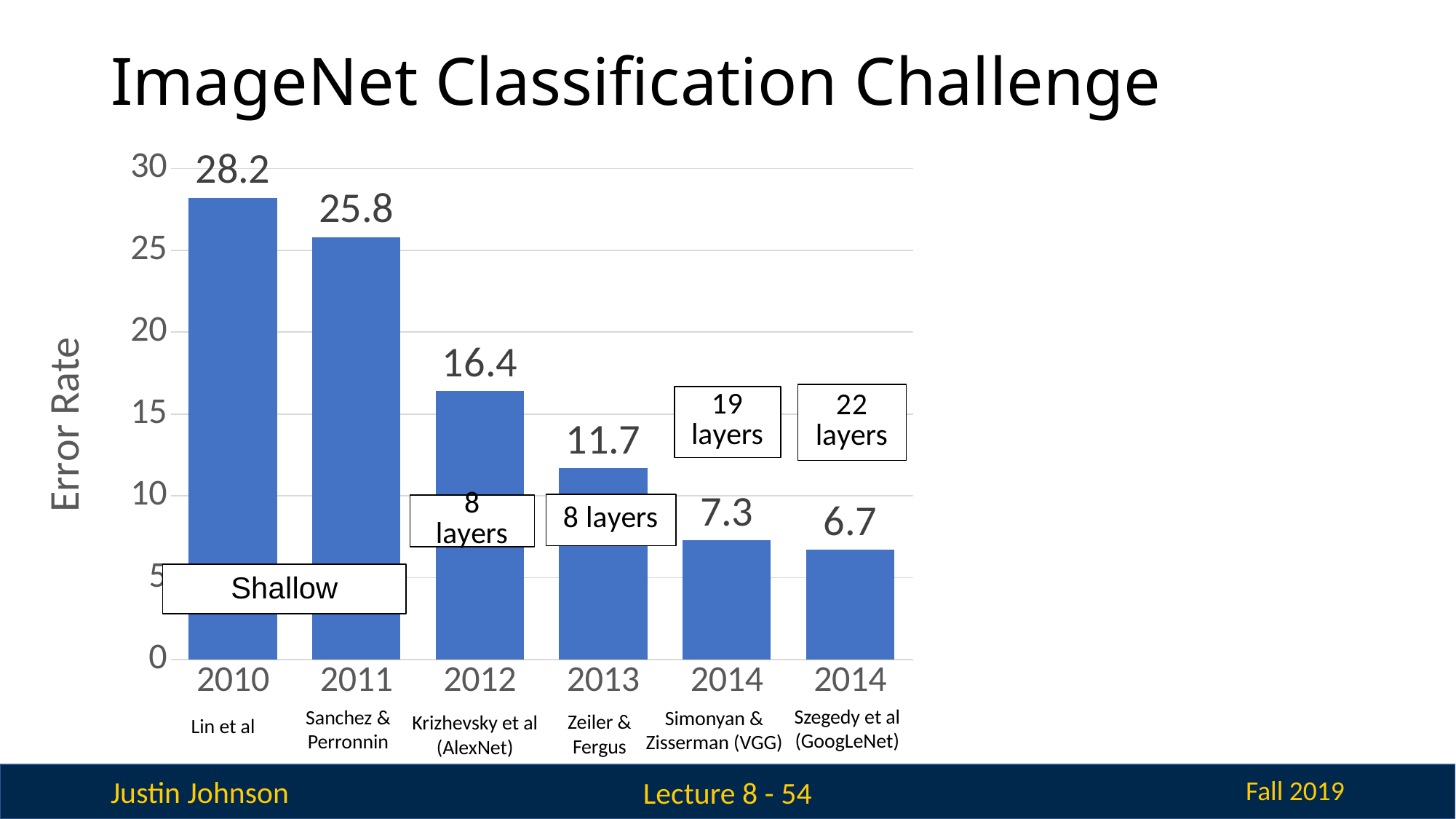
What is the error rate shown for Zeiler & Fergus (2013)? 11.7 Which entry has the lowest error rate? Szegedy et al (GoogLeNet) What is the difference in error rate between Sanchez & Perronnin (2011) and Krizhevsky et al (AlexNet, 2012)? 9.4 What kind of chart is shown on the slide? Bar chart What is the error rate shown for Krizhevsky et al (AlexNet) in 2012? 16.4 What is the error rate shown for Lin et al (2010)? 28.2 What is the label on the y axis of the chart? Error Rate Which has a higher error rate, Simonyan & Zisserman (VGG) or Szegedy et al (GoogLeNet)? Simonyan & Zisserman (VGG) Does the error rate rise or fall from 2010 to 2014 along the x axis? Fall Which entry has the highest error rate? Lin et al (2010) What is the error rate shown for Szegedy et al (GoogLeNet)? 6.7 How many bars are plotted in the chart? 6